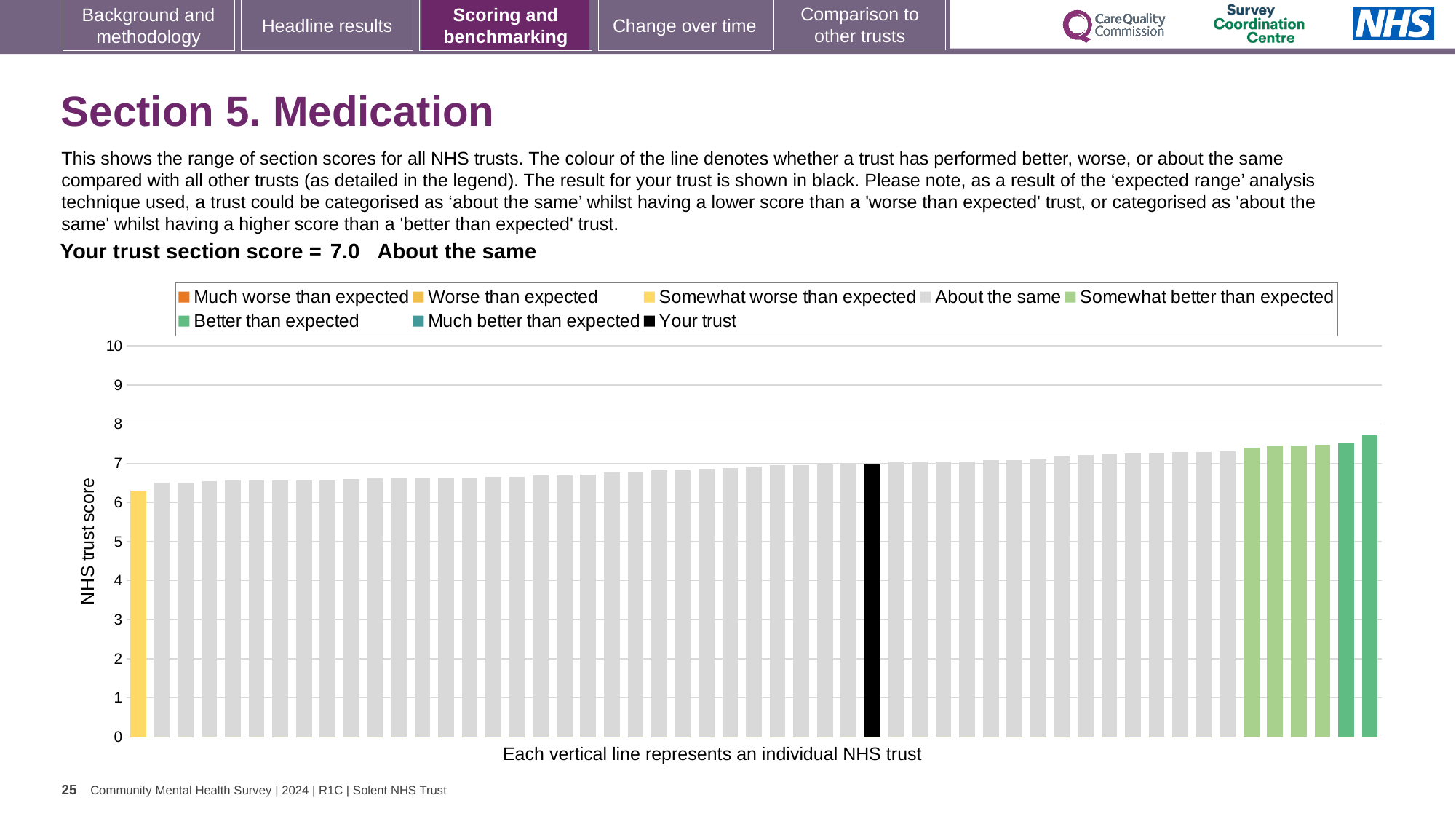
Is the value of the black bar for your trust greater or less than 5? greater Is the value of the leftmost (yellow) bar greater or less than 5? greater Is the value of the tallest bar greater or less than 8? less What is the section score for your trust shown on the slide? 7.0 What is the label on the vertical axis of the chart? NHS trust score How is your trust's section score categorised compared with other trusts? About the same Which bar is the lowest: the leftmost bar or the rightmost bar? the leftmost bar How many entries does the chart legend list? 8 Do the bar values rise or fall from left to right along the x axis? rise What kind of chart is shown on the slide? bar chart What colour is the bar representing your trust? black